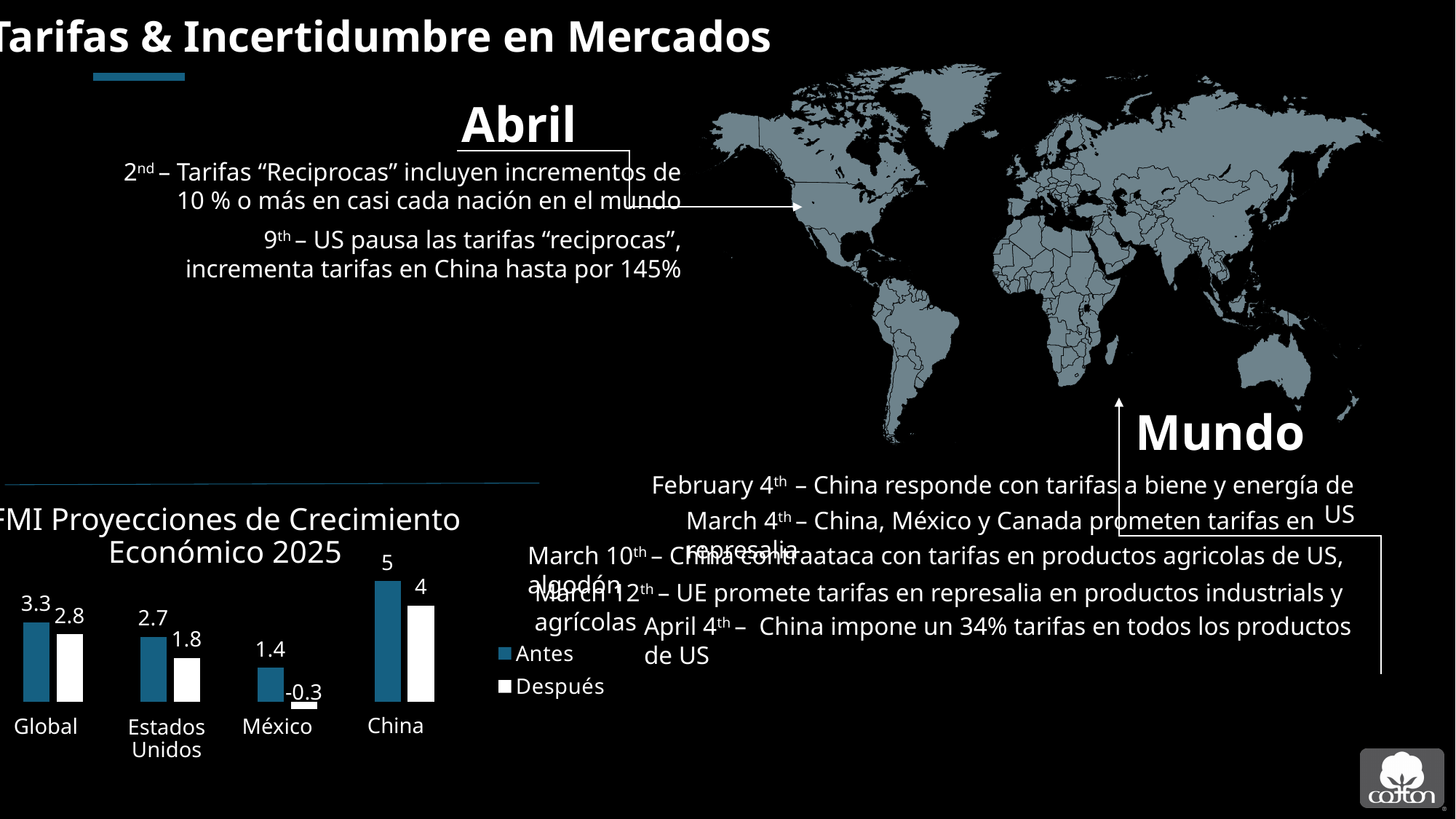
In the FMI Proyecciones de Crecimiento Económico 2025 chart, is the 'Después' value for Global larger or smaller than the 'Antes' value for Estados Unidos? larger What is the difference between the 'Antes' and 'Después' values for China in the FMI Proyecciones de Crecimiento Económico 2025 chart? 1 What is the 'Antes' value for Global in the FMI Proyecciones de Crecimiento Económico 2025 chart? 3.3 What is the 'Después' value for China in the FMI Proyecciones de Crecimiento Económico 2025 chart? 4 How many series does the legend of the FMI Proyecciones de Crecimiento Económico 2025 chart list? 2 Which category has the highest 'Antes' value in the FMI Proyecciones de Crecimiento Económico 2025 chart? China What is the 'Después' value for México in the FMI Proyecciones de Crecimiento Económico 2025 chart? -0.3 Which category has the lowest 'Después' value in the FMI Proyecciones de Crecimiento Económico 2025 chart? México What is the 'Antes' value for Estados Unidos in the FMI Proyecciones de Crecimiento Económico 2025 chart? 2.7 What is the difference between the 'Antes' and 'Después' values for Estados Unidos in the FMI Proyecciones de Crecimiento Económico 2025 chart? 0.9 How many categories are shown in the FMI Proyecciones de Crecimiento Económico 2025 chart? 4 What type of chart is the FMI Proyecciones de Crecimiento Económico 2025 chart? Bar chart